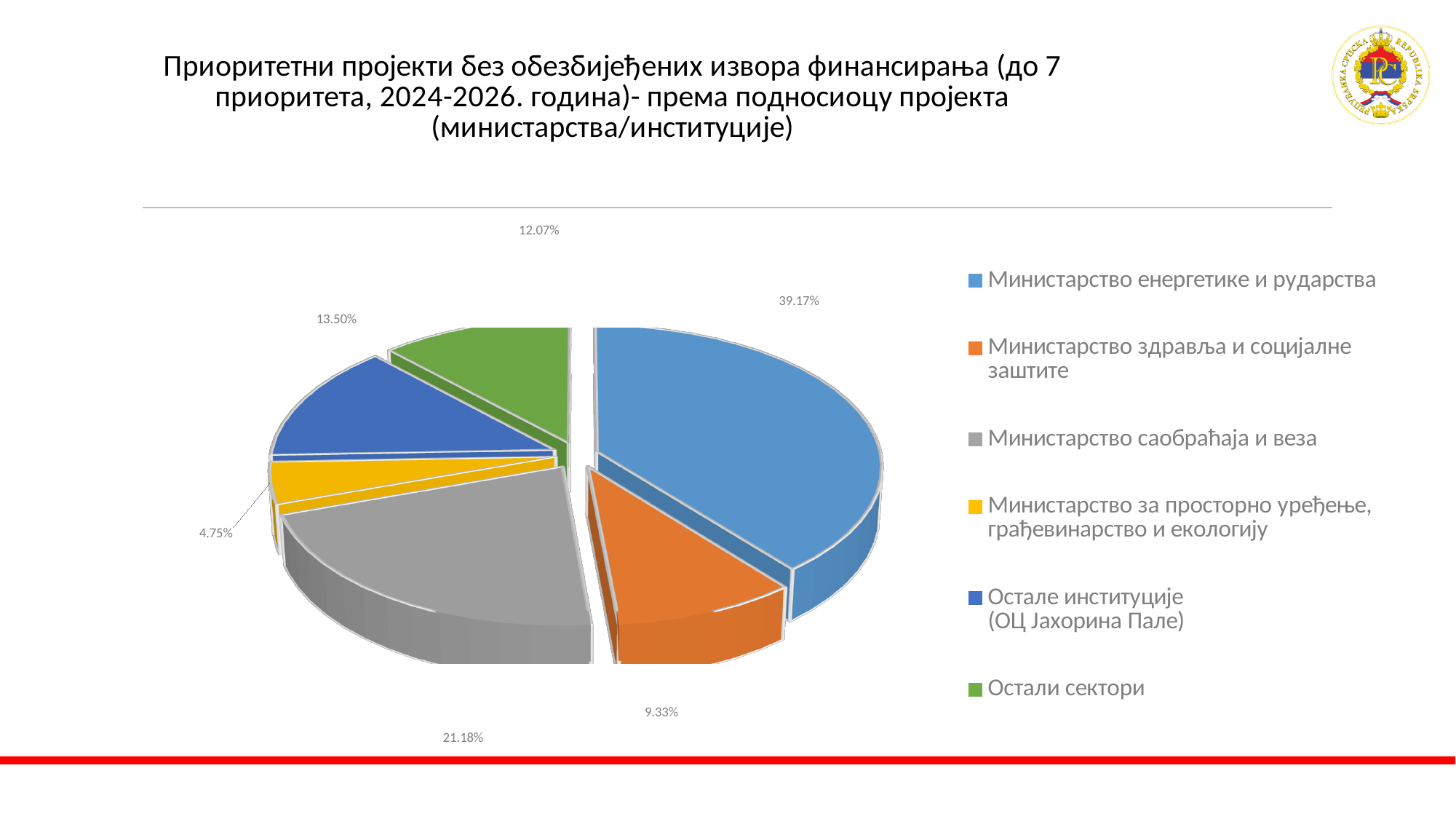
Which is larger: the share for Остале институције (ОЦ Јахорина Пале) or the share for Остали сектори? Остале институције (ОЦ Јахорина Пале) Which category has the smallest share of the pie? Министарство за просторно уређење, грађевинарство и екологију What is the value for Министарство за просторно уређење, грађевинарство и екологију? 4.75% What percentage is shown for Министарство здравља и социјалне заштите? 9.33% What share is shown for Остале институције (ОЦ Јахорина Пале)? 13.50% How many slices does the pie chart have? 6 Which category has the largest share of the pie? Министарство енергетике и рударства What is the value shown for Министарство саобраћаја и веза? 21.18% What kind of chart is shown on the slide? Pie chart What share of the pie does Министарство енергетике и рударства hold? 39.17% What percentage is shown for Остали сектори? 12.07% What is the difference in percentage points between Министарство енергетике и рударства and Министарство саобраћаја и веза? 17.99